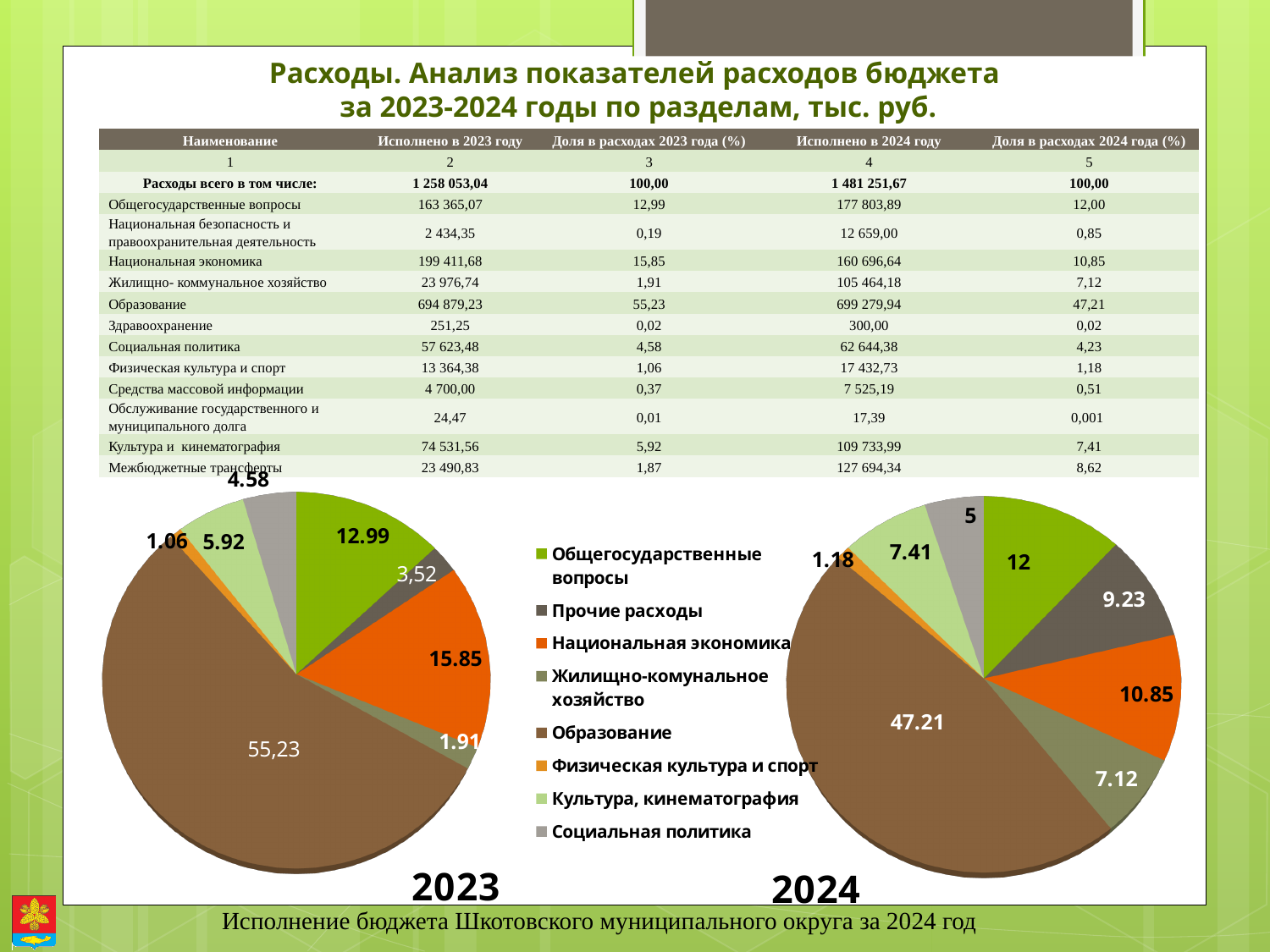
How many slices does the 2024 pie chart have? 8 In the 2024 pie chart, what is the value shown for Образование? 47.21 In the 2023 pie chart, which category has the largest slice? Образование In the 2023 pie chart, what is the value shown for Образование? 55,23 In the 2024 pie chart, what is the value shown for Национальная экономика? 10.85 What kind of chart is the 2023 chart on the slide? pie chart How many entries does the legend shared by the two pie charts list? 8 In the 2023 pie chart, which is larger: Национальная экономика or Общегосударственные вопросы? Национальная экономика In the 2024 pie chart, what is the value shown for Жилищно-коммунальное хозяйство? 7.12 In the 2024 pie chart, which category has the smallest slice? Физическая культура и спорт In the 2023 pie chart, what is the value shown for Прочие расходы? 3,52 In the 2024 pie chart, what is the difference between the values for Общегосударственные вопросы and Прочие расходы? 2.77